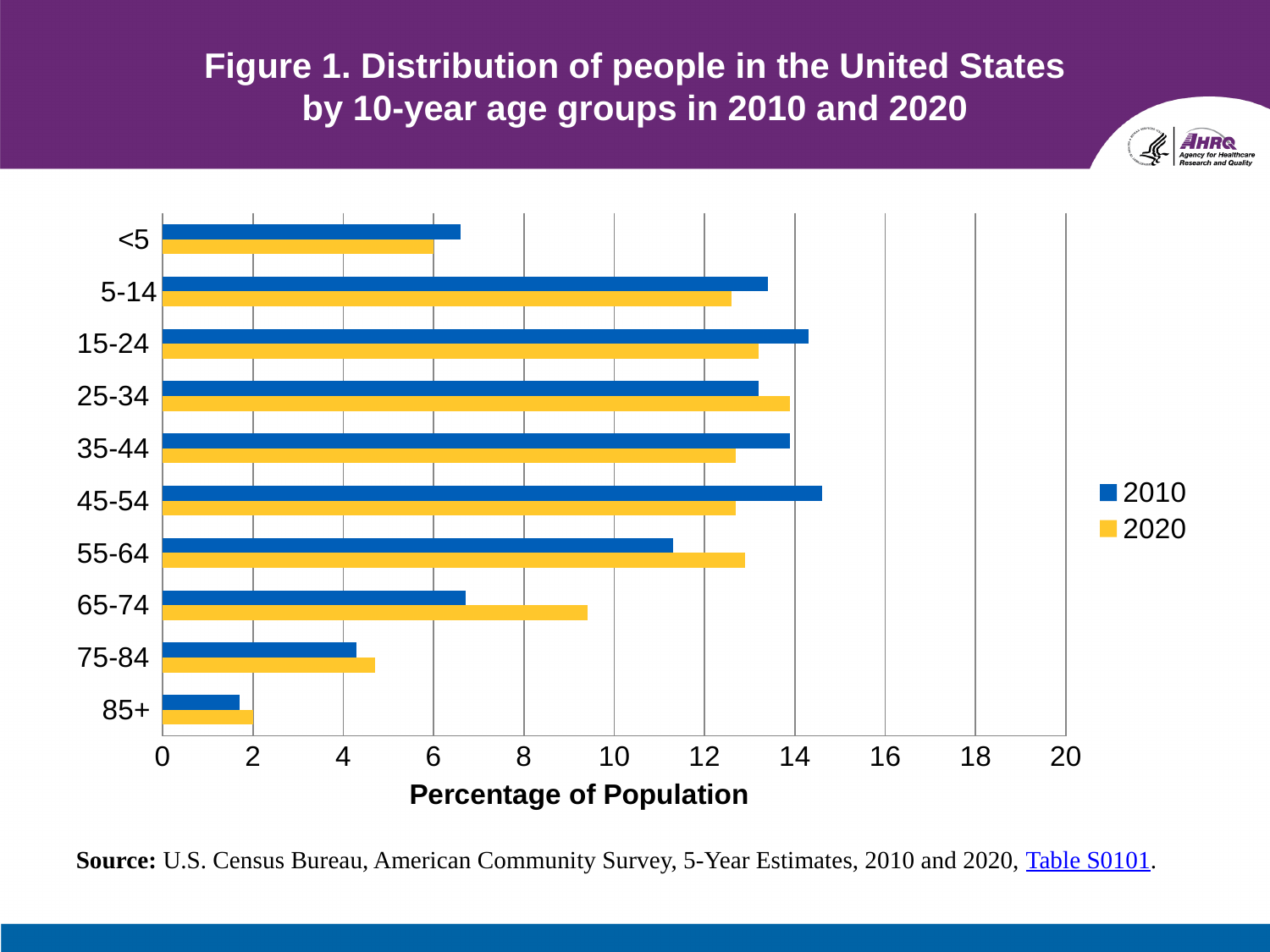
For the 45-54 age group, which year has the larger value, 2010 or 2020? 2010 Which age group has the lowest value for 2020? 85+ What kind of chart is shown on the slide? bar chart For the 65-74 age group, which year has the larger value, 2010 or 2020? 2020 How many age groups are shown on the chart? 10 Is the 2010 value for the 85+ age group greater or less than 2? less Is the 2010 value for the 55-64 age group greater or less than 10? greater What is the title of the horizontal axis? Percentage of Population Is the 2020 value for the 65-74 age group greater or less than 8? greater Which age group has the highest value for 2020? 25-34 Which age group has the lowest value for 2010? 85+ How many series does the legend list? 2